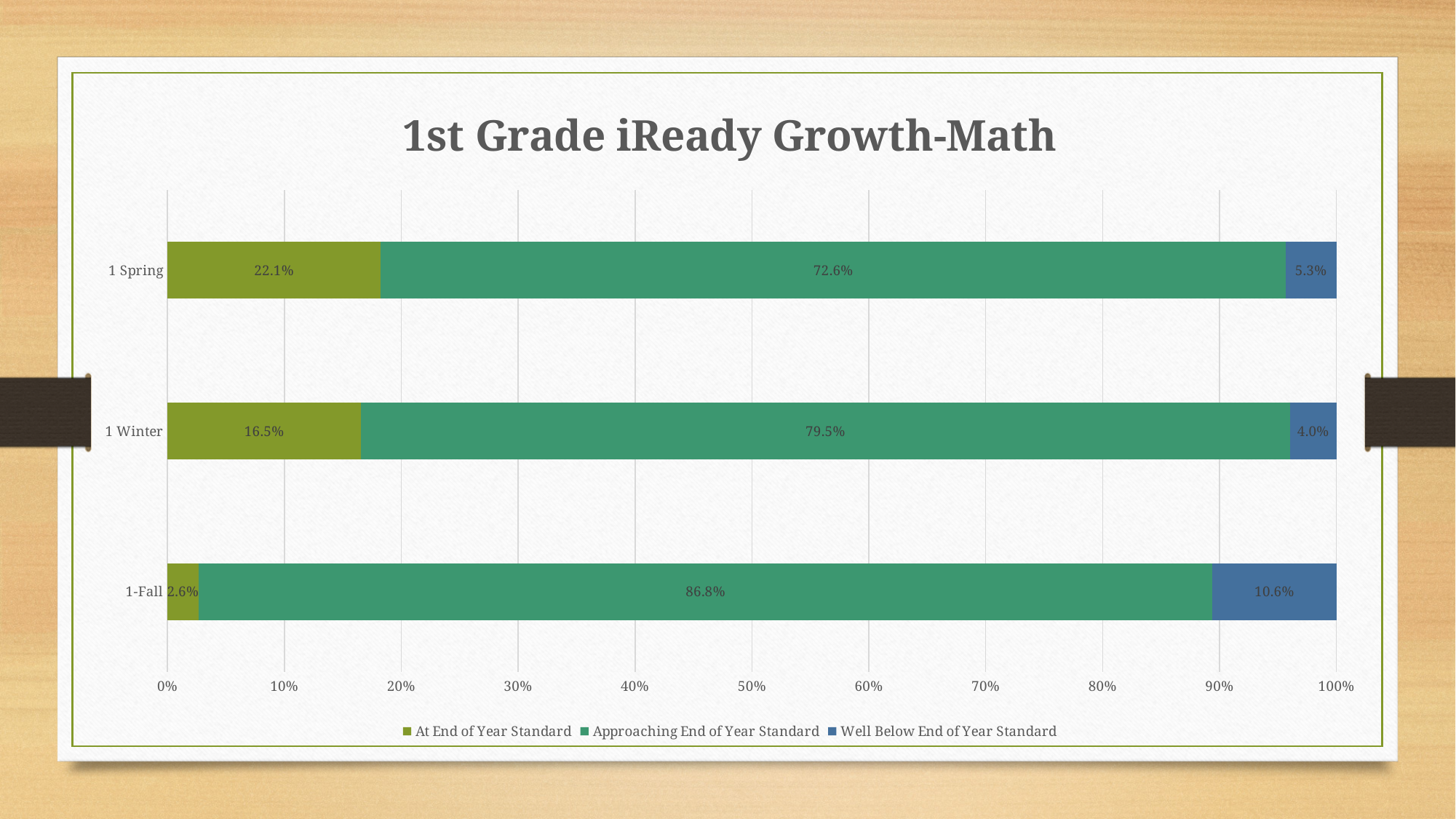
Which is larger: Approaching End of Year Standard in 1 Winter or in 1 Spring? 1 Winter What kind of chart is shown on the slide? Stacked bar chart How many categories are shown on the chart? 3 What is the total of the stacked bar for 1-Fall? 100.0% What is the title of the chart? 1st Grade iReady Growth-Math Which category has the lowest value for Well Below End of Year Standard? 1 Winter What is the value for Well Below End of Year Standard in 1 Winter? 4.0% How many series does the legend list? 3 What is the value for Approaching End of Year Standard in 1-Fall? 86.8% What is the value for At End of Year Standard in 1 Spring? 22.1% Which category has the highest value for At End of Year Standard? 1 Spring What is the difference between the At End of Year Standard values for 1 Spring and 1 Winter? 5.6%